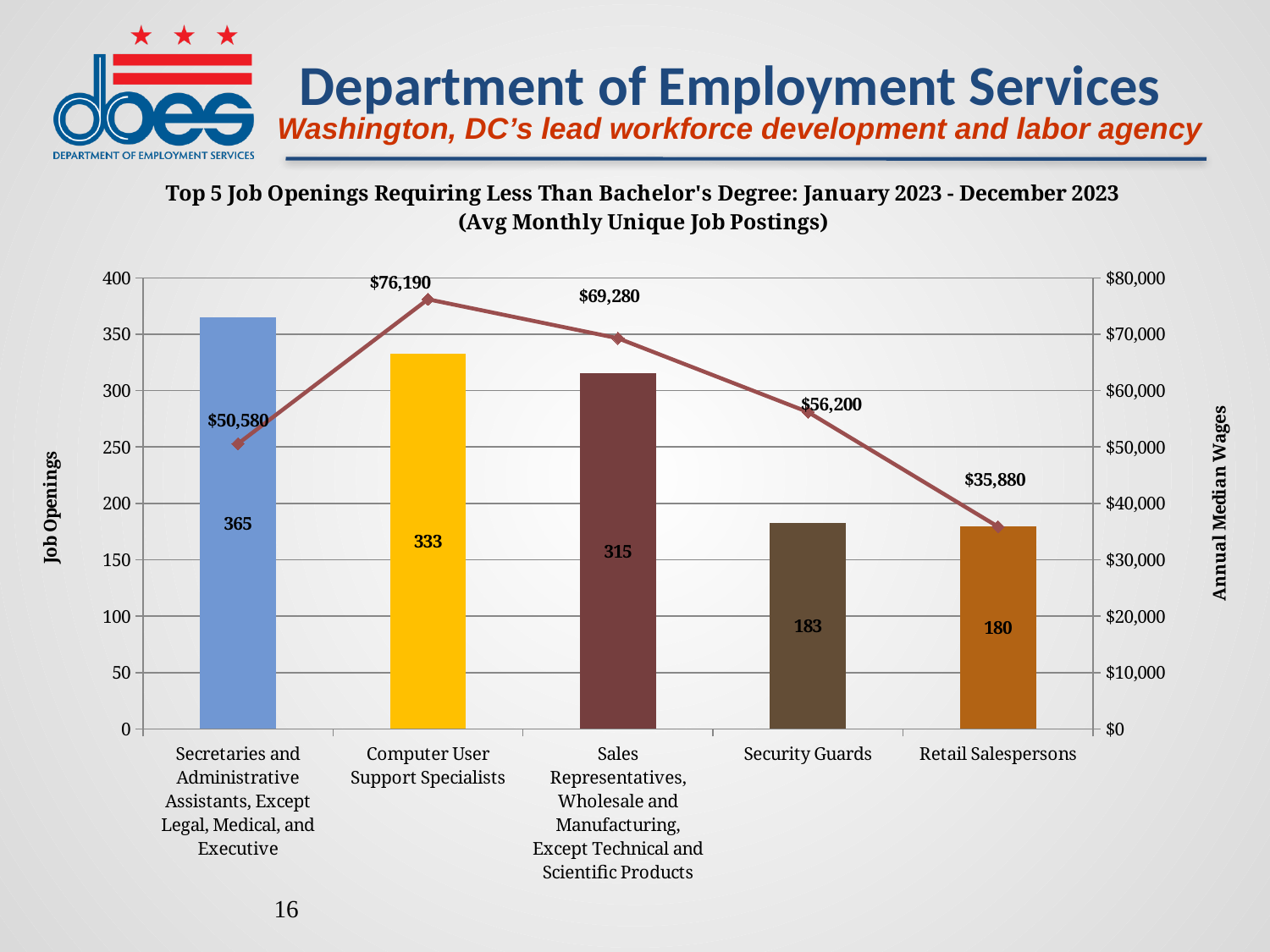
Which occupation has the lowest annual median wage? Retail Salespersons Which occupation has the highest annual median wage? Computer User Support Specialists What is the annual median wage shown for Retail Salespersons? $35,880 What is the label of the right-hand vertical axis? Annual Median Wages What is the annual median wage shown for Security Guards? $56,200 What is the title of the chart? Top 5 Job Openings Requiring Less Than Bachelor's Degree: January 2023 - December 2023 (Avg Monthly Unique Job Postings) Which occupation has the highest number of job openings? Secretaries and Administrative Assistants, Except Legal, Medical, and Executive What is the difference in annual median wage between Computer User Support Specialists and Sales Representatives, Wholesale and Manufacturing? $6,910 How many job openings are shown for Computer User Support Specialists? 333 What is the difference in job openings between Secretaries and Administrative Assistants and Retail Salespersons? 185 How many occupations are shown on the chart? 5 Which has more job openings: Sales Representatives, Wholesale and Manufacturing or Security Guards? Sales Representatives, Wholesale and Manufacturing